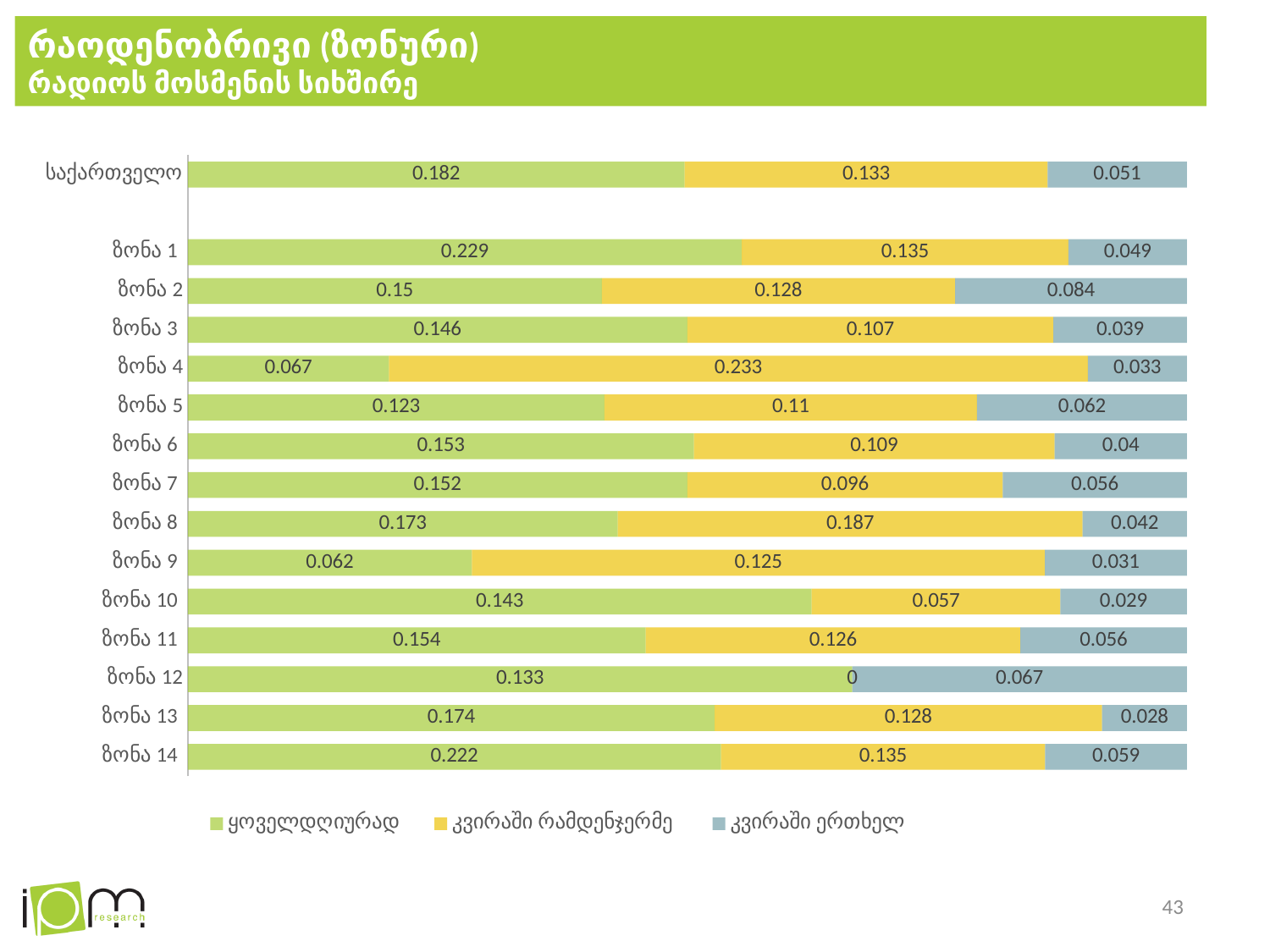
What is the total of the three values for ზონა 1? 0.413 How many categories are shown on the chart? 15 Which category has the highest კვირაში ერთხელ value? ზონა 2 What is the value of კვირაში რამდენჯერმე for ზონა 12? 0 Which category has the highest კვირაში რამდენჯერმე value? ზონა 4 Which category has the lowest ყოველდღიურად value? ზონა 9 Which has the larger კვირაში რამდენჯერმე value, ზონა 10 or ზონა 11? ზონა 11 What is the value of კვირაში ერთხელ for საქართველო? 0.051 How many series does the legend list? 3 What is the difference between the კვირაში რამდენჯერმე value and the ყოველდღიურად value for ზონა 8? 0.014 What is the value of ყოველდღიურად for ზონა 4? 0.067 Which category has the highest ყოველდღიურად value? ზონა 1